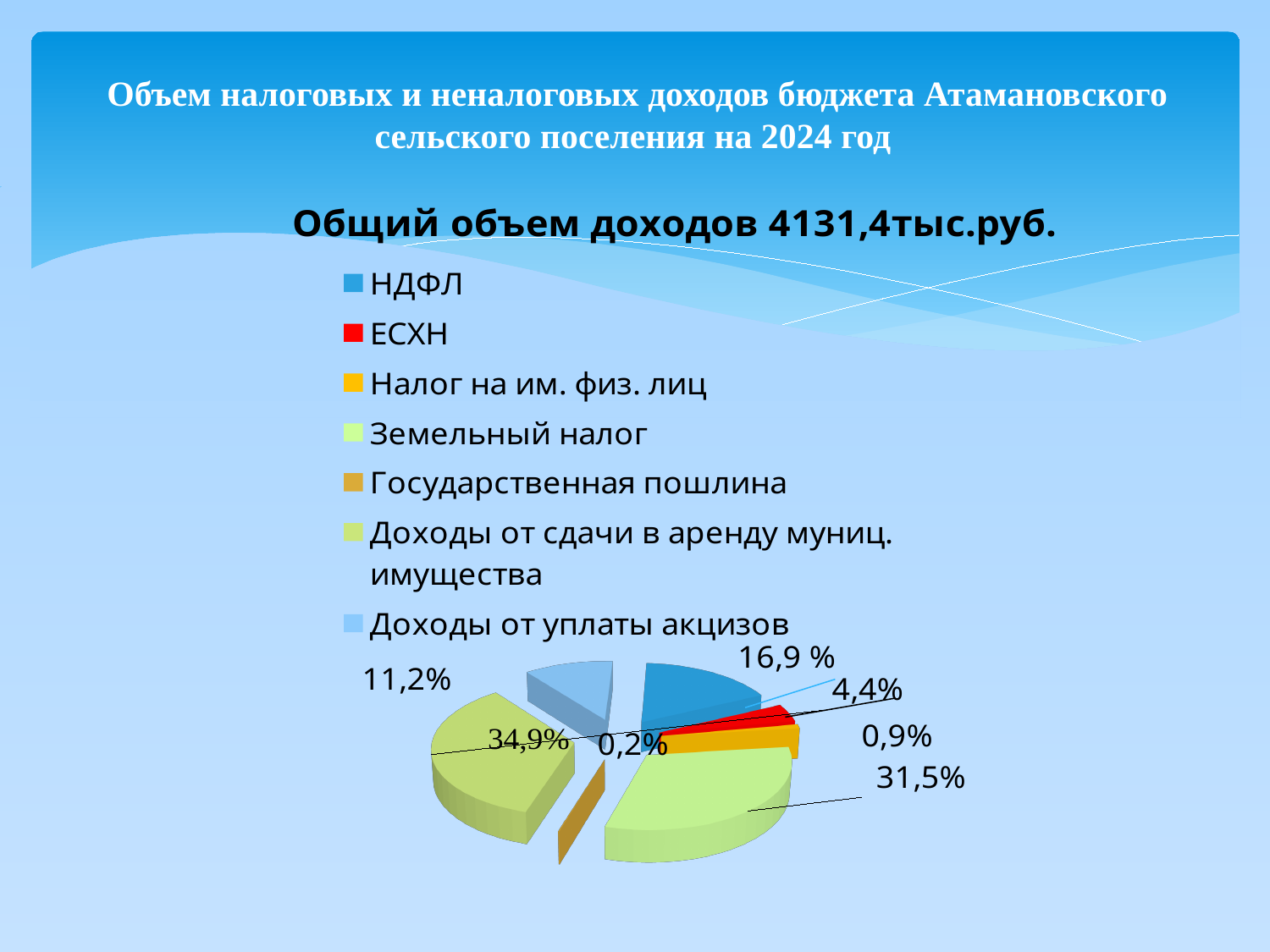
Which is larger in the pie chart: the share for НДФЛ or the share for Доходы от уплаты акцизов? НДФЛ What kind of chart is shown on the slide? pie chart What is the share for ЕСХН in the pie chart? 4,4% What is the share for НДФЛ in the pie chart? 16,9 % Which category has the largest share in the pie chart? Доходы от сдачи в аренду муниц. имущества What is the share for Доходы от уплаты акцизов in the pie chart? 11,2% What is the share for Доходы от сдачи в аренду муниц. имущества in the pie chart? 34,9% How many categories does the legend of the pie chart list? 7 What is the share for Земельный налог in the pie chart? 31,5% What is the share for Государственная пошлина in the pie chart? 0,2% What is the title of the pie chart? Общий объем доходов 4131,4тыс.руб. Which category has the smallest share in the pie chart? Государственная пошлина